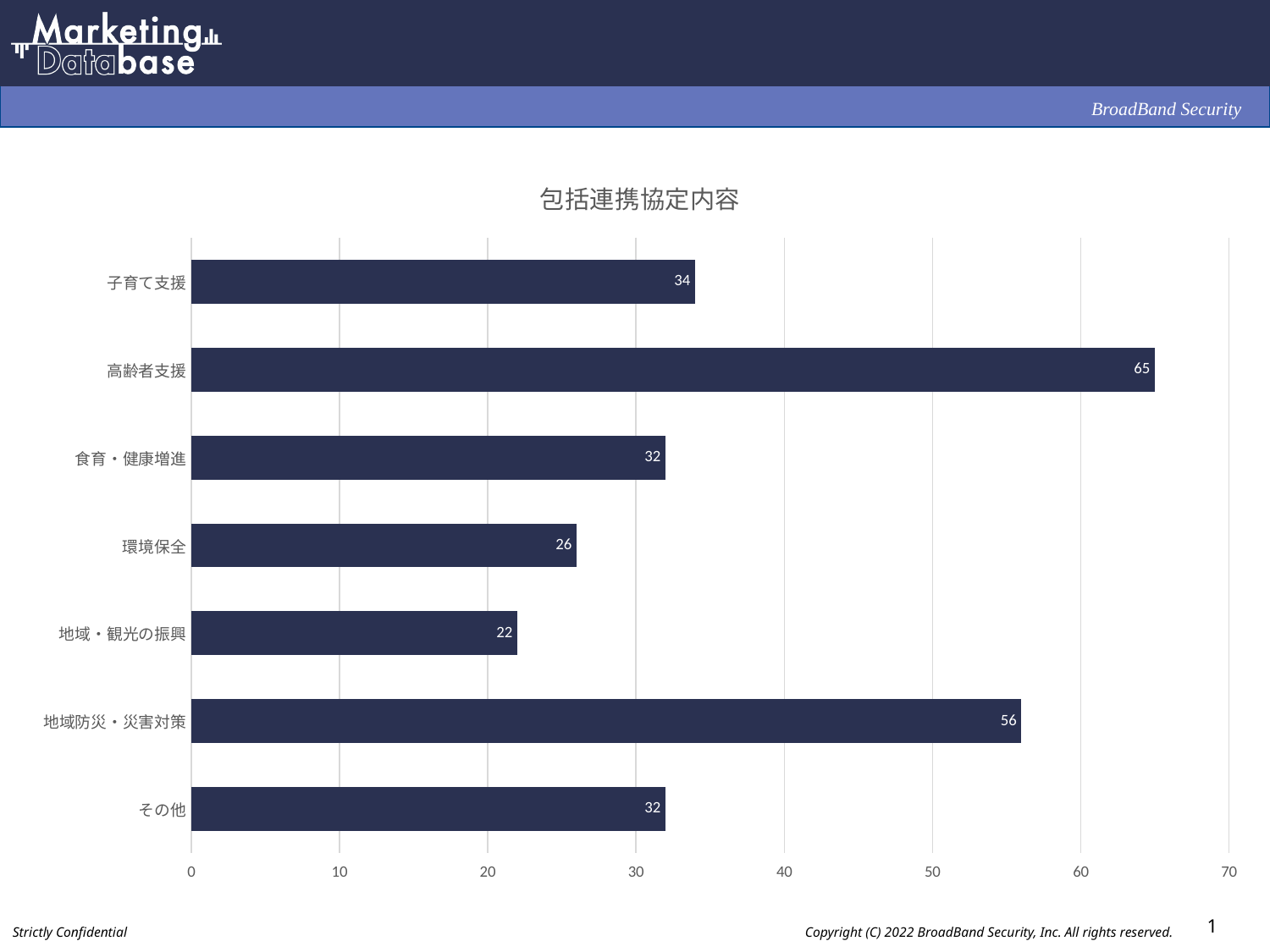
What is the value for 高齢者支援? 65 What is the value for その他? 32 Which category has the highest value? 高齢者支援 Is the value for 地域防災・災害対策 greater or less than 50? greater Which category has the lowest value? 地域・観光の振興 What kind of chart is shown on the slide? bar chart What is the difference between the values for 高齢者支援 and 地域防災・災害対策? 9 Which is larger, the value for 子育て支援 or the value for 食育・健康増進? 子育て支援 What is the value for 環境保全? 26 How many categories are shown in the chart? 7 What is the title of the chart? 包括連携協定内容 What is the value for 地域・観光の振興? 22